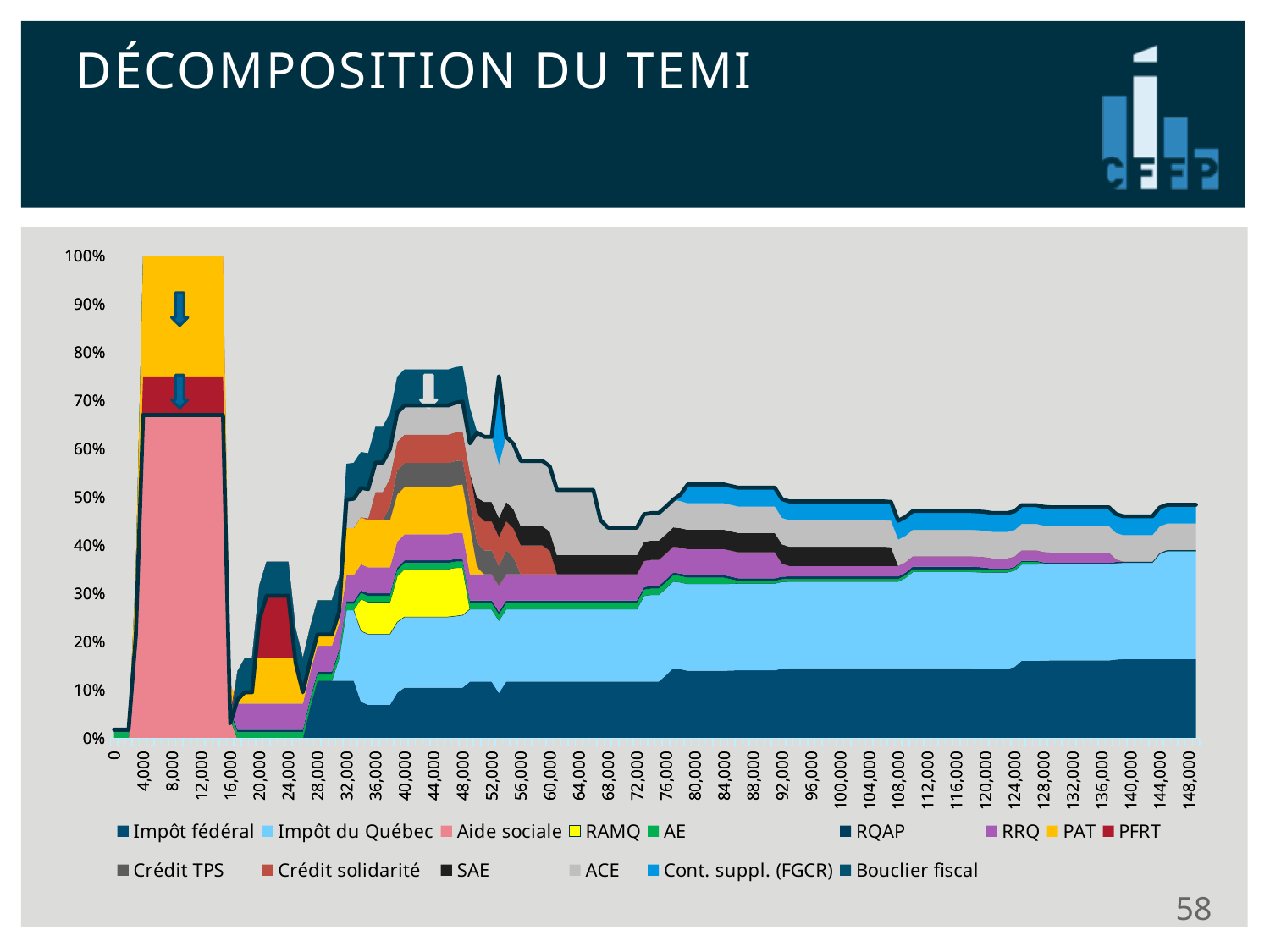
Is the value for Impôt fédéral at 148,000 greater or less than 20%? less What is the title of the slide containing the chart? DÉCOMPOSITION DU TEMI What kind of chart is shown on the slide? stacked area chart How many series does the chart legend list? 15 Is the total stacked value at 40,000 greater or less than 70%? greater Which has the larger total stacked value: 8,000 or 148,000? 8,000 Between 40,000 and 72,000 on the x axis, does the total stacked value rise or fall? fall Is the total stacked value at 20,000 greater or less than 40%? less Which has the larger total stacked value: 20,000 or 40,000? 40,000 What is the highest value shown on the chart's vertical axis? 100%